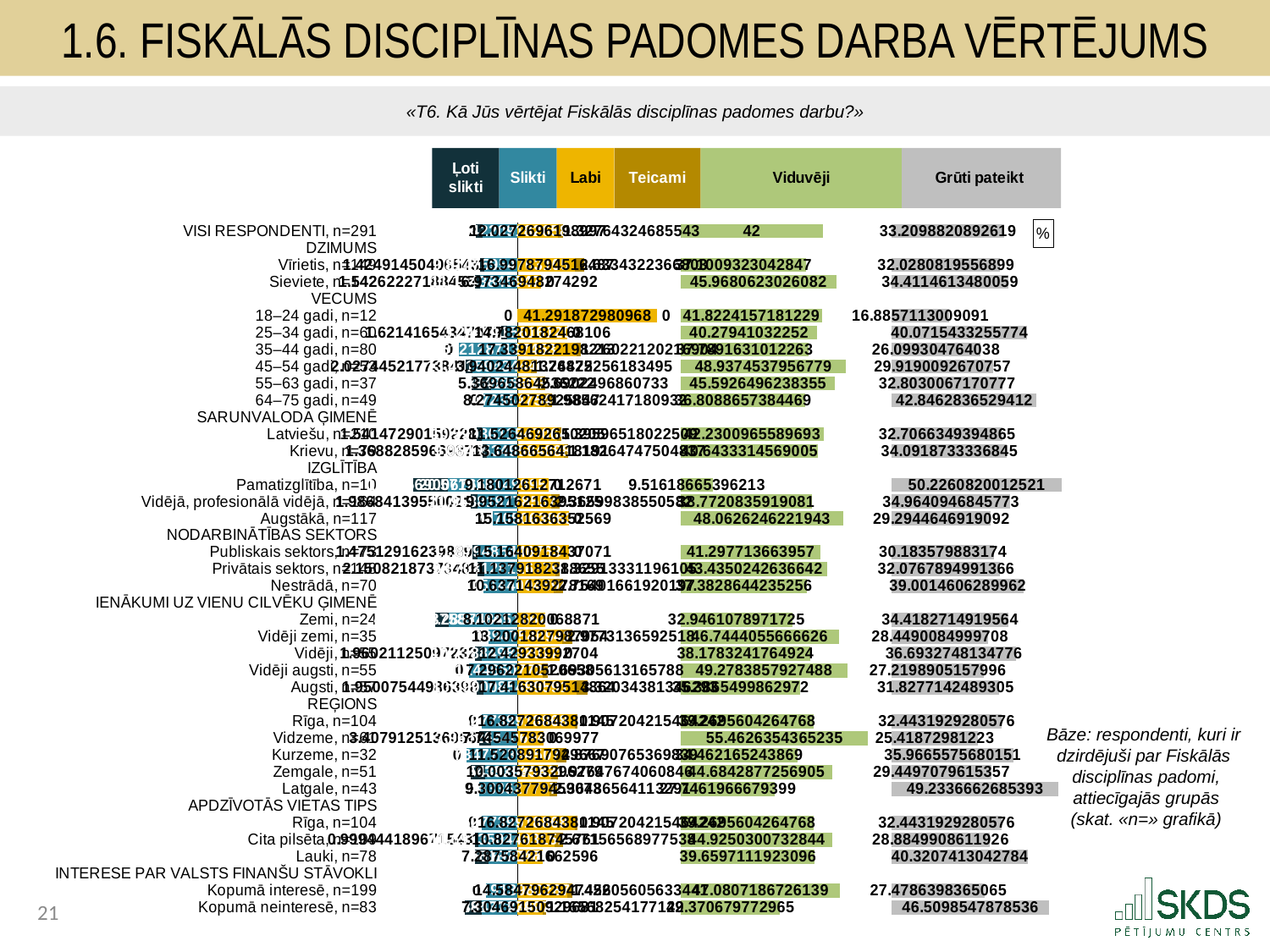
What is the Grūti pateikt value for VISI RESPONDENTI, n=291? 33.2098820892619 What is the Grūti pateikt value for Latgale, n=43? 49.2336662685393 What is the Viduvēji value for VISI RESPONDENTI, n=291? 42 What is the Viduvēji value for Augstākā, n=117? 48.0626246221943 What is the Grūti pateikt value for Pamatizglītība, n=10? 50.2260820012521 What kind of chart is shown on the slide? Stacked bar chart How many series does the legend list? 6 Which is larger, the Grūti pateikt value for Latgale, n=43 or for Rīga, n=104? Latgale, n=43 Which region has the lowest Grūti pateikt value? Vidzeme, n=61 What survey question is quoted above the chart? «T6. Kā Jūs vērtējat Fiskālās disciplīnas padomes darbu?» What is the Grūti pateikt value for Kopumā neinteresē, n=83? 46.5098547878536